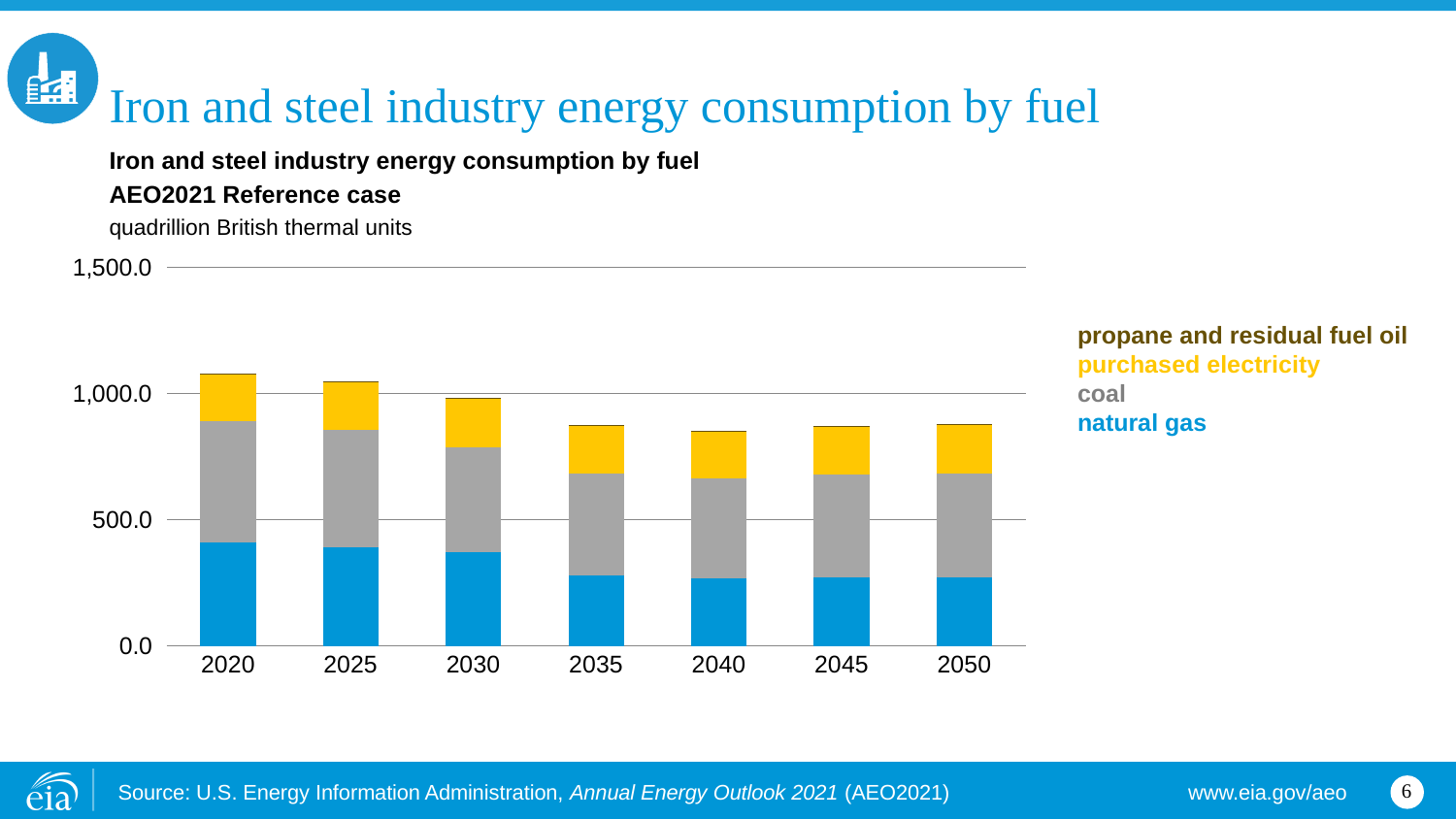
Is the total energy consumption for 2035 greater or less than 1,000.0? less How many fuel series does the legend list? 4 Which year has the highest total energy consumption? 2020 Which fuel is shown in blue at the bottom of each bar? natural gas Which year has the larger total energy consumption, 2020 or 2050? 2020 What unit is the chart measured in? quadrillion British thermal units Is the total energy consumption for 2020 greater or less than 1,000.0? greater Does total energy consumption rise or fall from 2020 to 2035? fall Is the natural gas value for 2020 greater or less than 500.0? less What kind of chart is shown on the slide? stacked bar chart How many years are shown on the x axis of the chart? 7